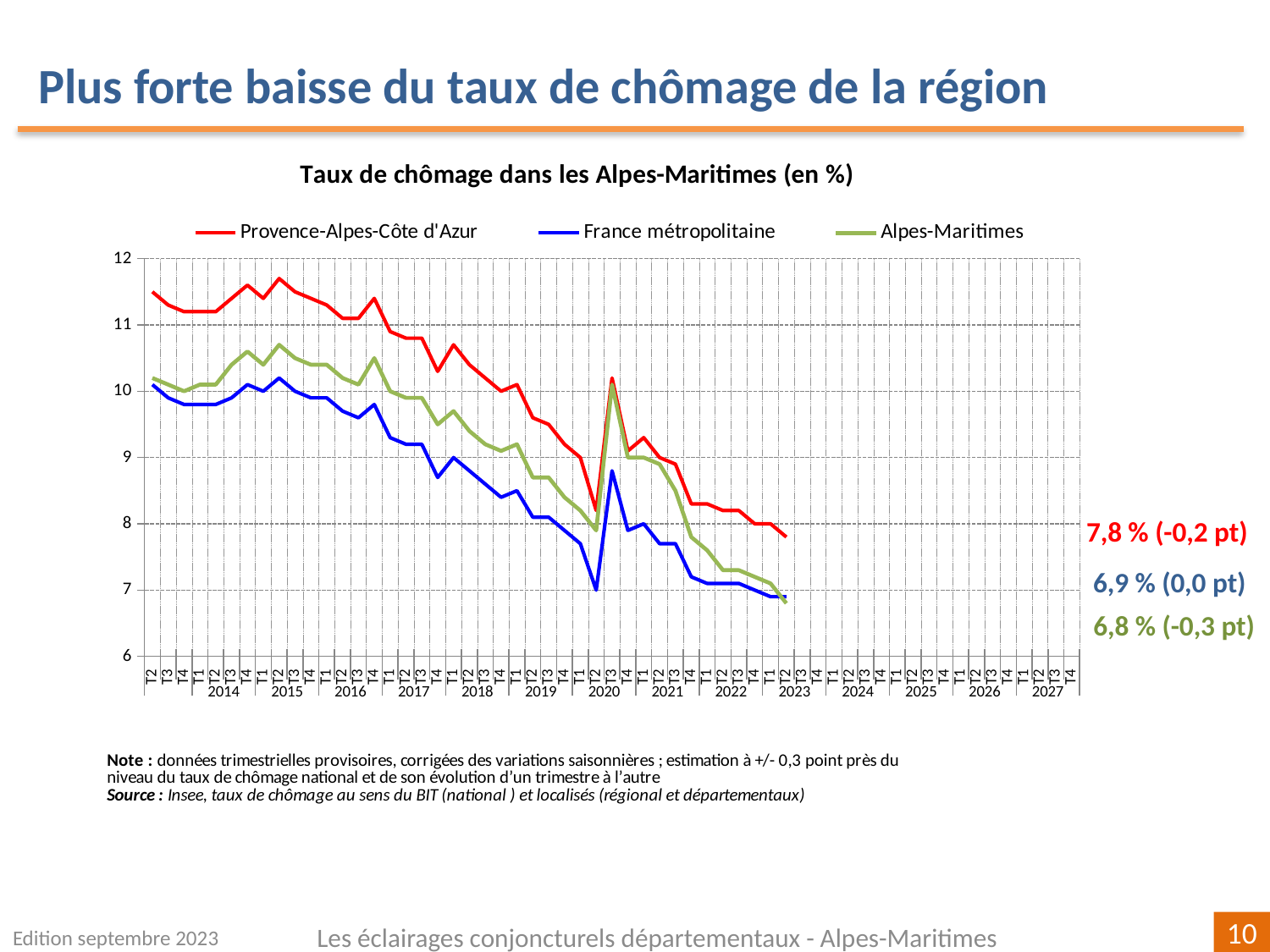
What quarterly change is printed next to the latest Alpes-Maritimes value? -0,3 pt What is the latest unemployment rate shown for Alpes-Maritimes? 6,8 % What is the latest unemployment rate shown for Provence-Alpes-Côte d'Azur? 7,8 % How many series does the legend list? 3 Overall, do the unemployment rates rise or fall from 2014 to 2023? fall Which series is higher at the end of the chart, Provence-Alpes-Côte d'Azur or Alpes-Maritimes? Provence-Alpes-Côte d'Azur Is the value for Provence-Alpes-Côte d'Azur in T2 2015 greater or less than 11? greater What is the latest unemployment rate shown for France métropolitaine? 6,9 % What is the difference between the latest values for Provence-Alpes-Côte d'Azur and France métropolitaine? 0,9 pt What kind of chart is shown on the slide? line chart What colour is the line for France métropolitaine? blue Which of the three series has the lowest latest value? Alpes-Maritimes